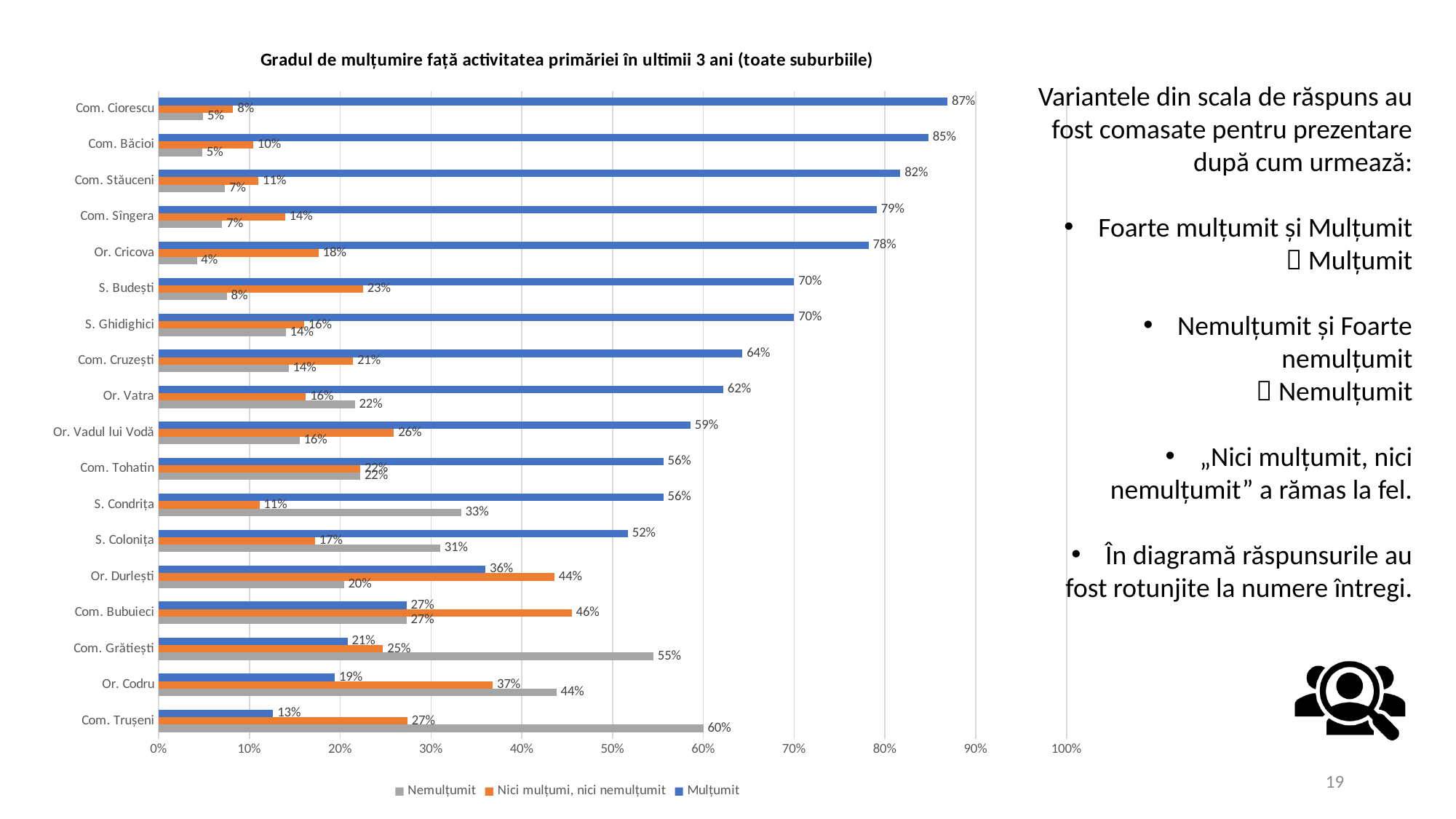
What is the Nemulțumit value for Com. Trușeni? 60% Which colour represents the Mulțumit series in the chart? blue How many series does the legend list? 3 What is the difference between the Mulțumit values for Com. Băcioi and Or. Codru? 66% What is the 'Nici mulțumi, nici nemulțumit' value for Com. Bubuieci? 46% What is the Mulțumit value for Com. Ciorescu? 87% Which locality has the highest Mulțumit value? Com. Ciorescu What type of chart is shown on the slide? bar chart Which locality has the lowest Mulțumit value? Com. Trușeni How many localities (categories) are shown on the chart? 18 Which is larger: the Nemulțumit value for Com. Grătiești or for Or. Codru? Com. Grătiești What is the title of the chart? Gradul de mulțumire față activitatea primăriei în ultimii 3 ani (toate suburbiile)